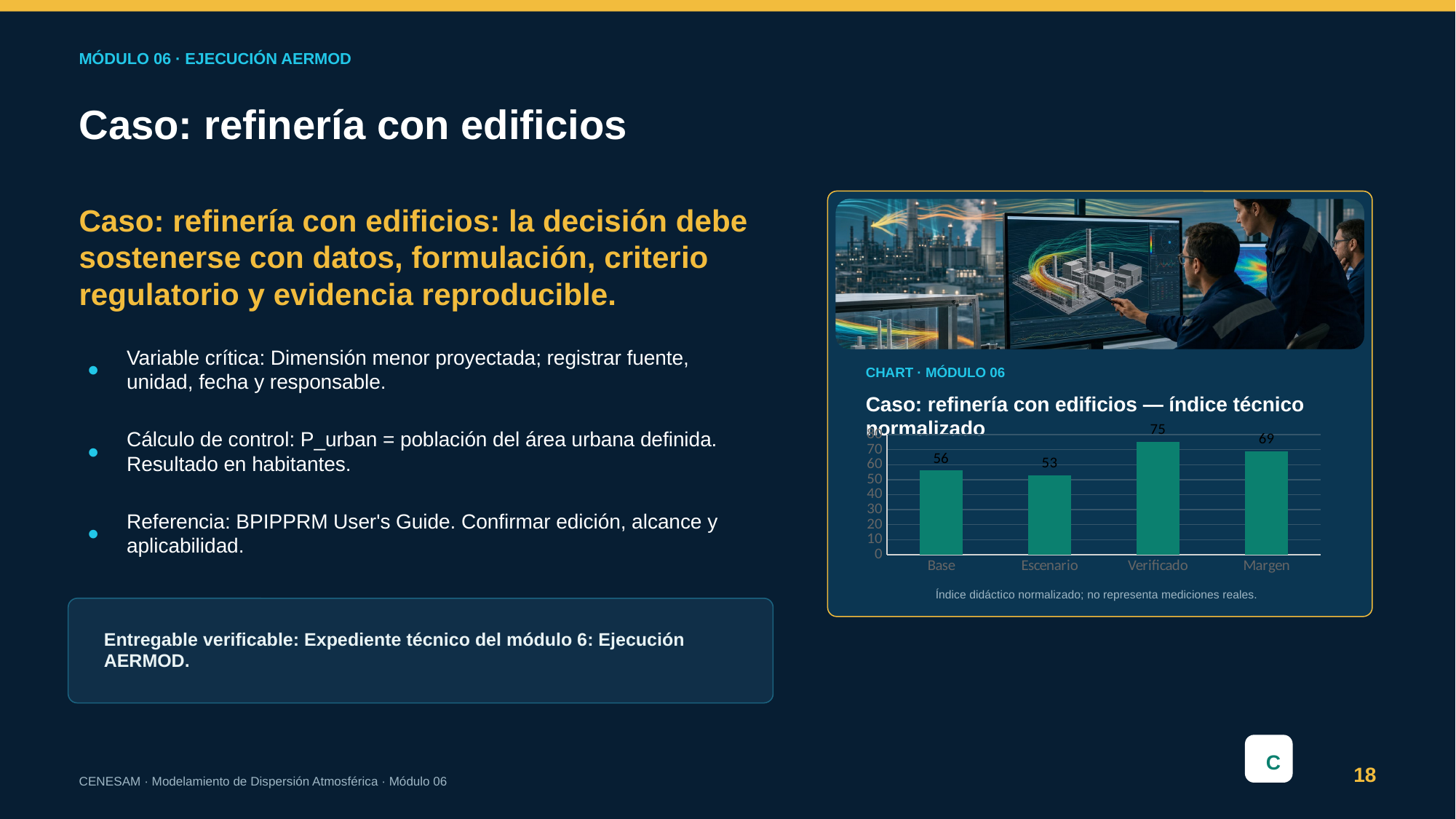
Which is larger, the value for Margen or the value for Base? Margen Which category has the highest value? Verificado What is the difference between the values for Verificado and Margen? 6 What is the value for Base? 56 What is the value for Escenario? 53 Which category has the lowest value? Escenario How many categories are shown on the x axis? 4 What is the title of the chart? Caso: refinería con edificios — índice técnico normalizado What is the difference between the values for Base and Escenario? 3 What is the value for Verificado? 75 What kind of chart is shown? Bar chart What is the value for Margen? 69